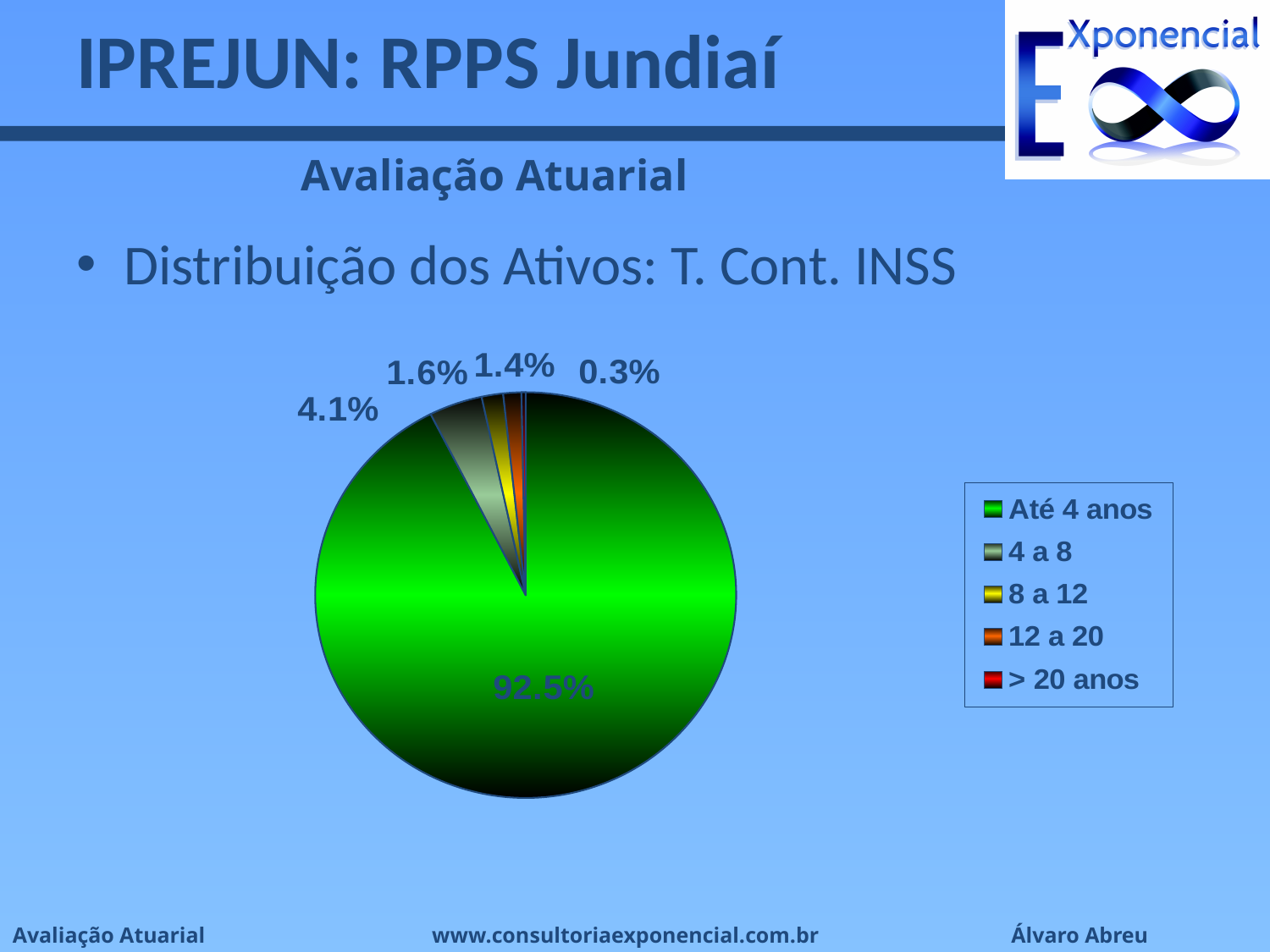
What is the value shown for the '4 a 8' slice? 4.1% Which is larger, the '12 a 20' slice or the '> 20 anos' slice? 12 a 20 What is the value shown for the '8 a 12' slice? 1.6% How many categories does the legend list? 5 What kind of chart is shown on the slide? pie chart What share of the pie does the 'Até 4 anos' slice represent? 92.5% Which category has the largest slice of the pie? Até 4 anos What is the value shown for the '> 20 anos' slice? 0.3% Which category has the smallest slice of the pie? > 20 anos What is the difference between the '4 a 8' slice and the '8 a 12' slice? 2.5% What colour is the 'Até 4 anos' slice in the pie chart? green What is the value shown for the '12 a 20' slice? 1.4%